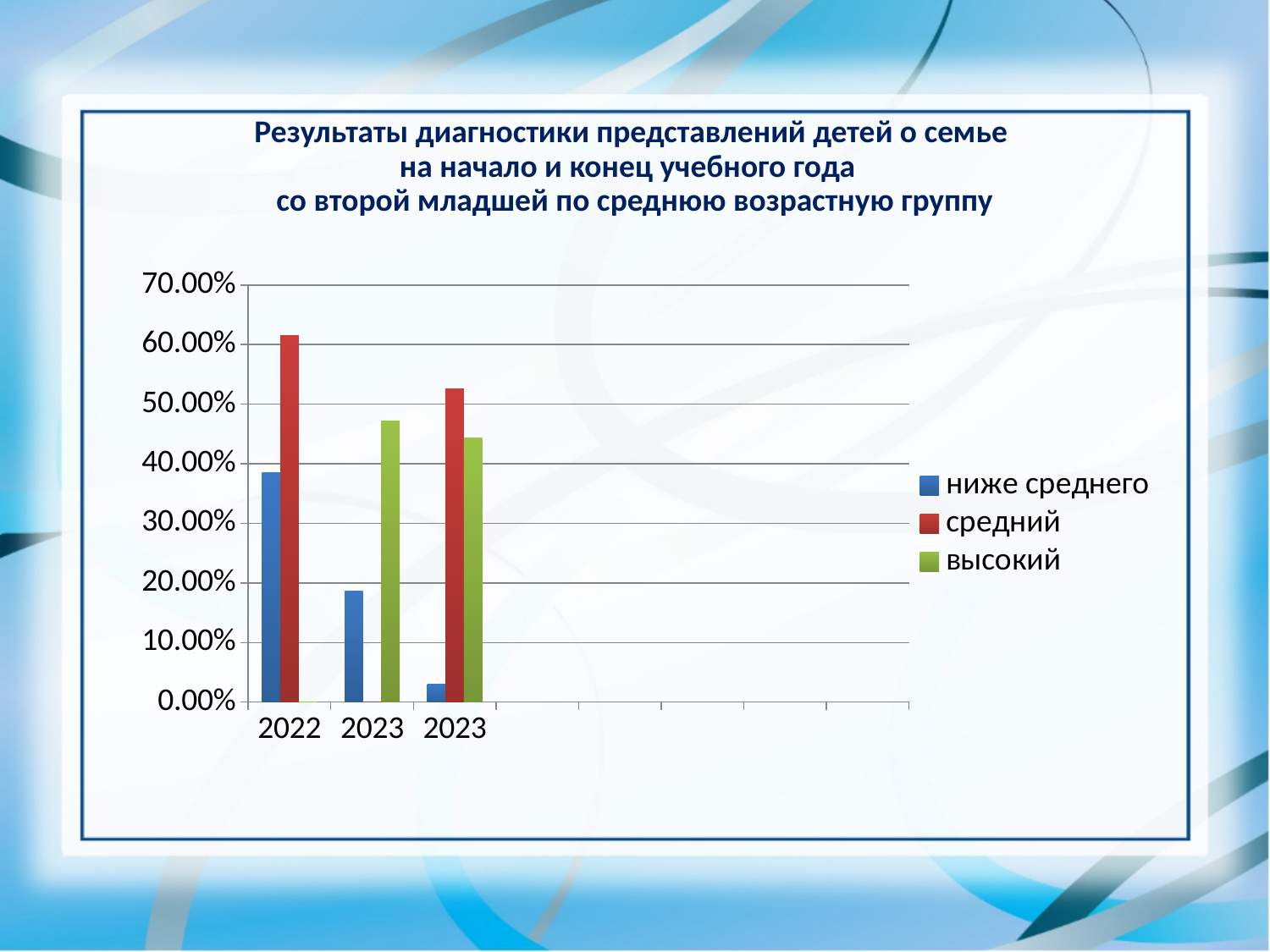
Is the value for высокий in the first 2023 category greater or less than 40%? greater Do the values for ниже среднего rise or fall from left to right along the x axis? fall Is the value for ниже среднего in the second 2023 category greater or less than 10%? less In the second 2023 category, which is larger: средний or высокий? средний Is the value for средний in 2022 greater or less than 50%? greater Which colour represents the series высокий in the legend? green Which series has the shortest bar in the whole chart? ниже среднего Which series has the tallest bar in the whole chart? средний What kind of chart is shown on the slide? bar chart How many series does the legend list? 3 How many categories are shown along the x axis? 3